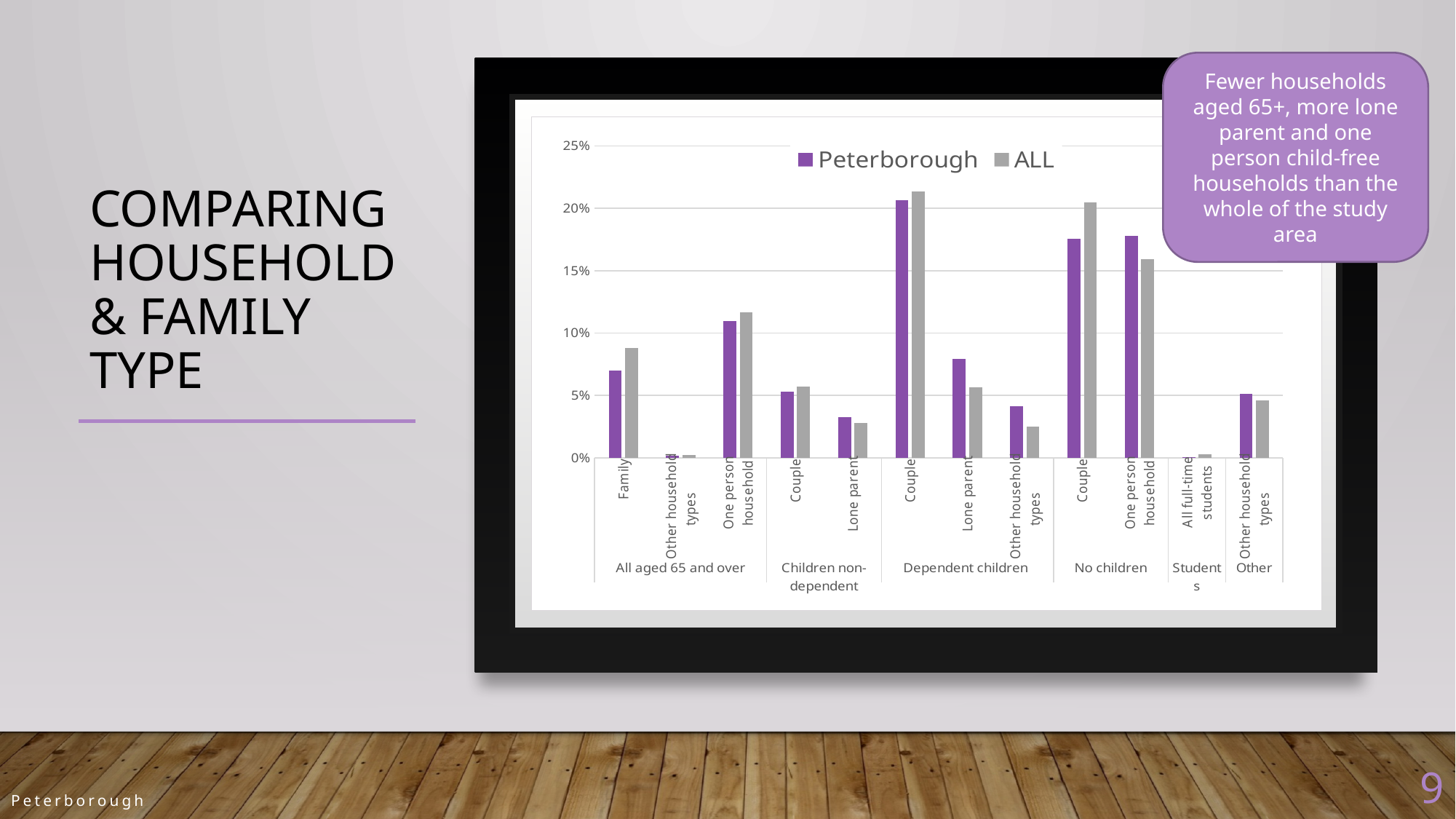
How many series does the legend list? 2 For One person household under No children, which series is larger, Peterborough or ALL? Peterborough For Family under All aged 65 and over, which series is larger, Peterborough or ALL? ALL For Lone parent under Dependent children, which series is larger, Peterborough or ALL? Peterborough Is the ALL value for Couple under Dependent children greater or less than 20%? greater Is the Peterborough value for One person household under All aged 65 and over greater or less than 10%? greater What are the two series named in the legend? Peterborough and ALL How many top-level household groups are shown along the x axis? 6 What kind of chart is shown on the slide? bar chart Which category has the highest Peterborough value? Couple (Dependent children) Which colour represents the Peterborough series? purple Is the ALL value for Lone parent under Children non-dependent greater or less than 5%? less